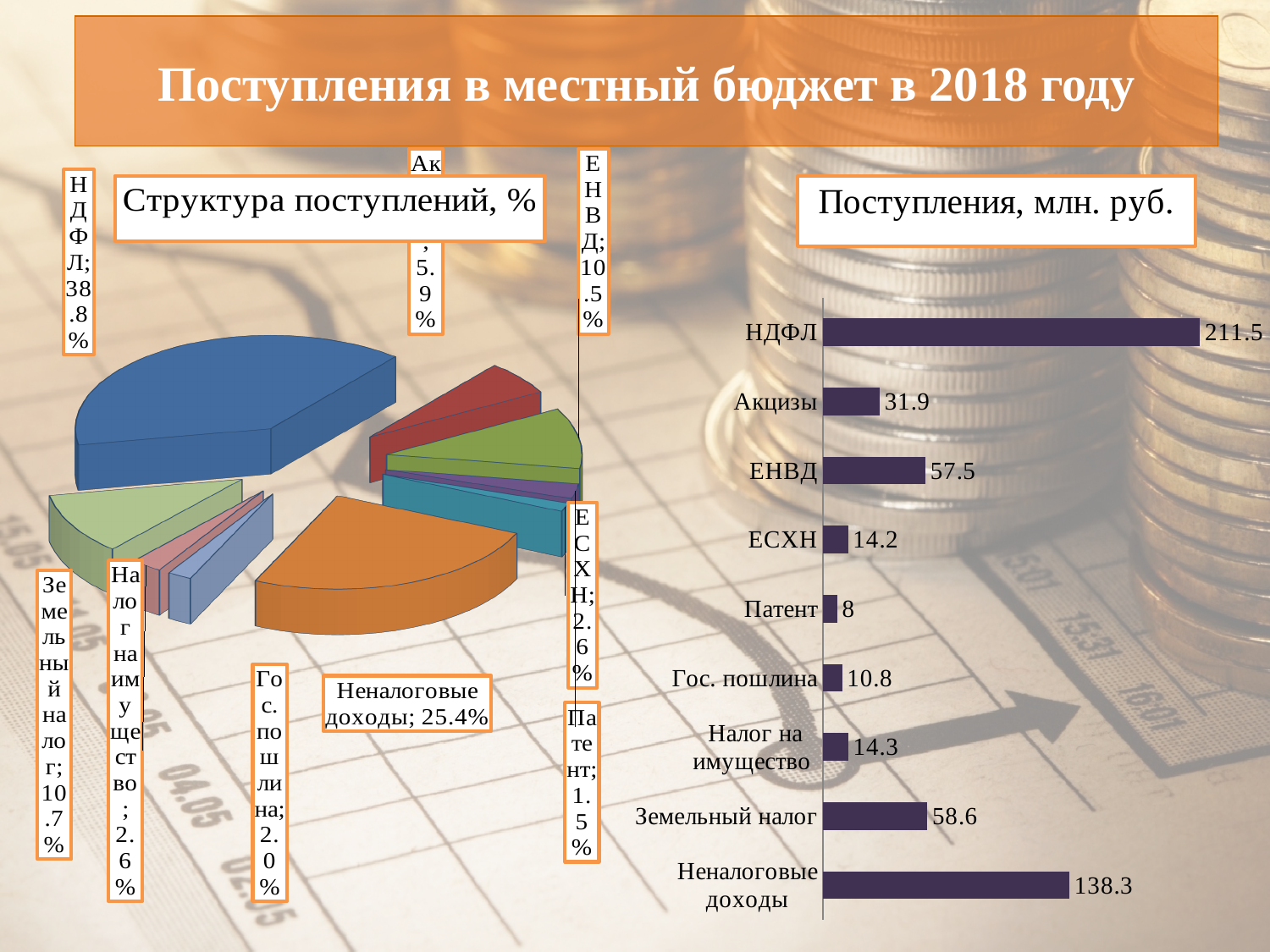
In the bar chart 'Поступления, млн. руб.', what is the value for НДФЛ? 211.5 In the pie chart 'Структура поступлений, %', what share does Земельный налог have? 10.7% In the bar chart 'Поступления, млн. руб.', which category has the highest value? НДФЛ How many categories are shown in the bar chart 'Поступления, млн. руб.'? 9 In the bar chart 'Поступления, млн. руб.', which category has the lowest value? Патент In the pie chart 'Структура поступлений, %', what share do Неналоговые доходы have? 25.4% In the pie chart 'Структура поступлений, %', what share does НДФЛ have? 38.8% In the bar chart 'Поступления, млн. руб.', which is larger: Акцизы or ЕНВД? ЕНВД What kind of chart is 'Поступления, млн. руб.'? bar chart What kind of chart is 'Структура поступлений, %'? pie chart In the bar chart 'Поступления, млн. руб.', what is the value for Земельный налог? 58.6 In the bar chart 'Поступления, млн. руб.', what is the difference between НДФЛ and Неналоговые доходы? 73.2